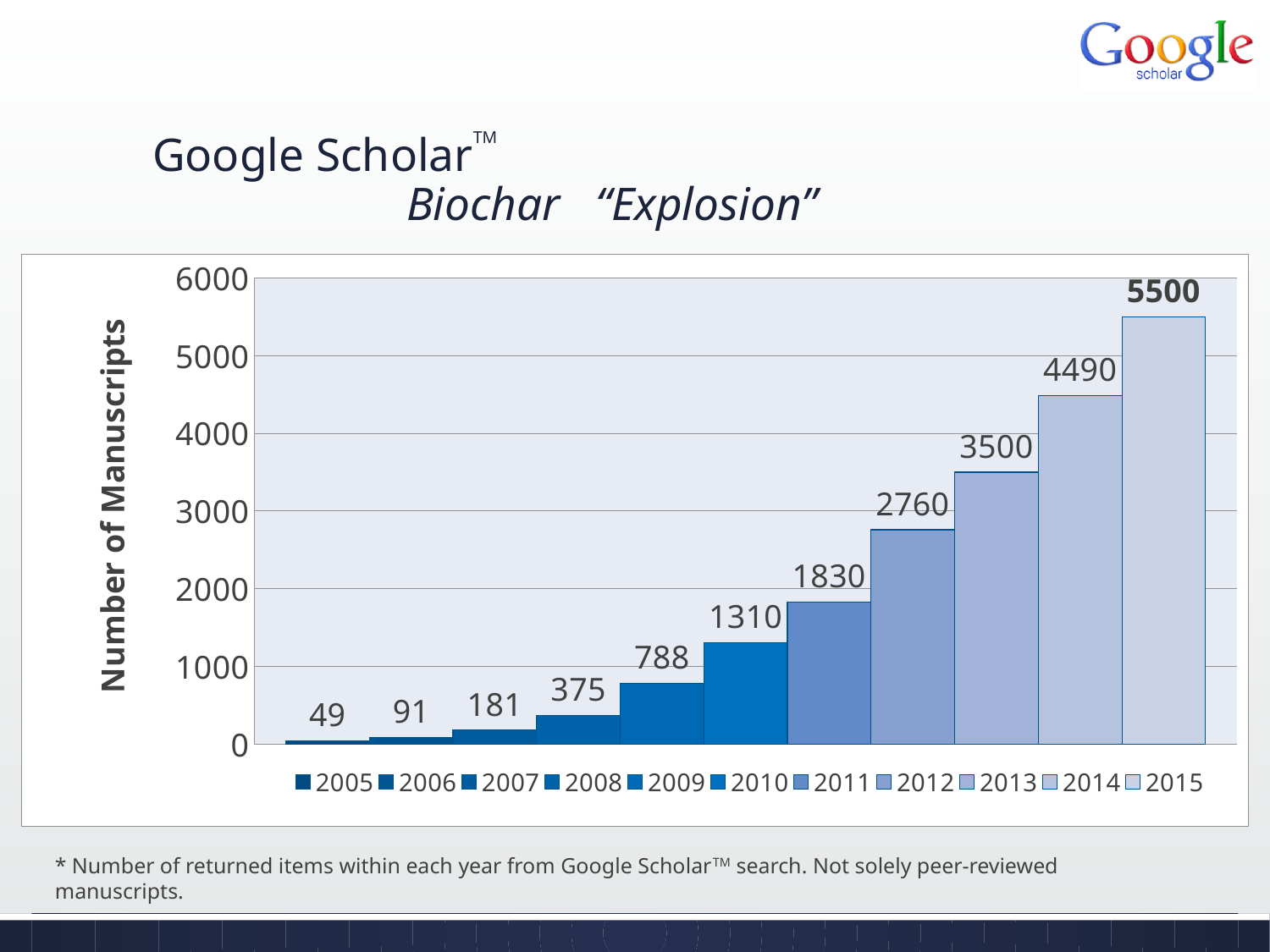
Do the values rise or fall from 2005 to 2015? rise How many years are shown in the chart? 11 Which year has more manuscripts, 2009 or 2011? 2011 What is the label of the vertical axis? Number of Manuscripts What kind of chart is shown on the slide? bar chart What is the number of manuscripts for 2010? 1310 Which year has the highest number of manuscripts? 2015 Is the value for 2012 greater or less than 3000? less Which year has the lowest number of manuscripts? 2005 What is the number of manuscripts for 2015? 5500 What is the difference in number of manuscripts between 2014 and 2013? 990 What is the number of manuscripts for 2005? 49